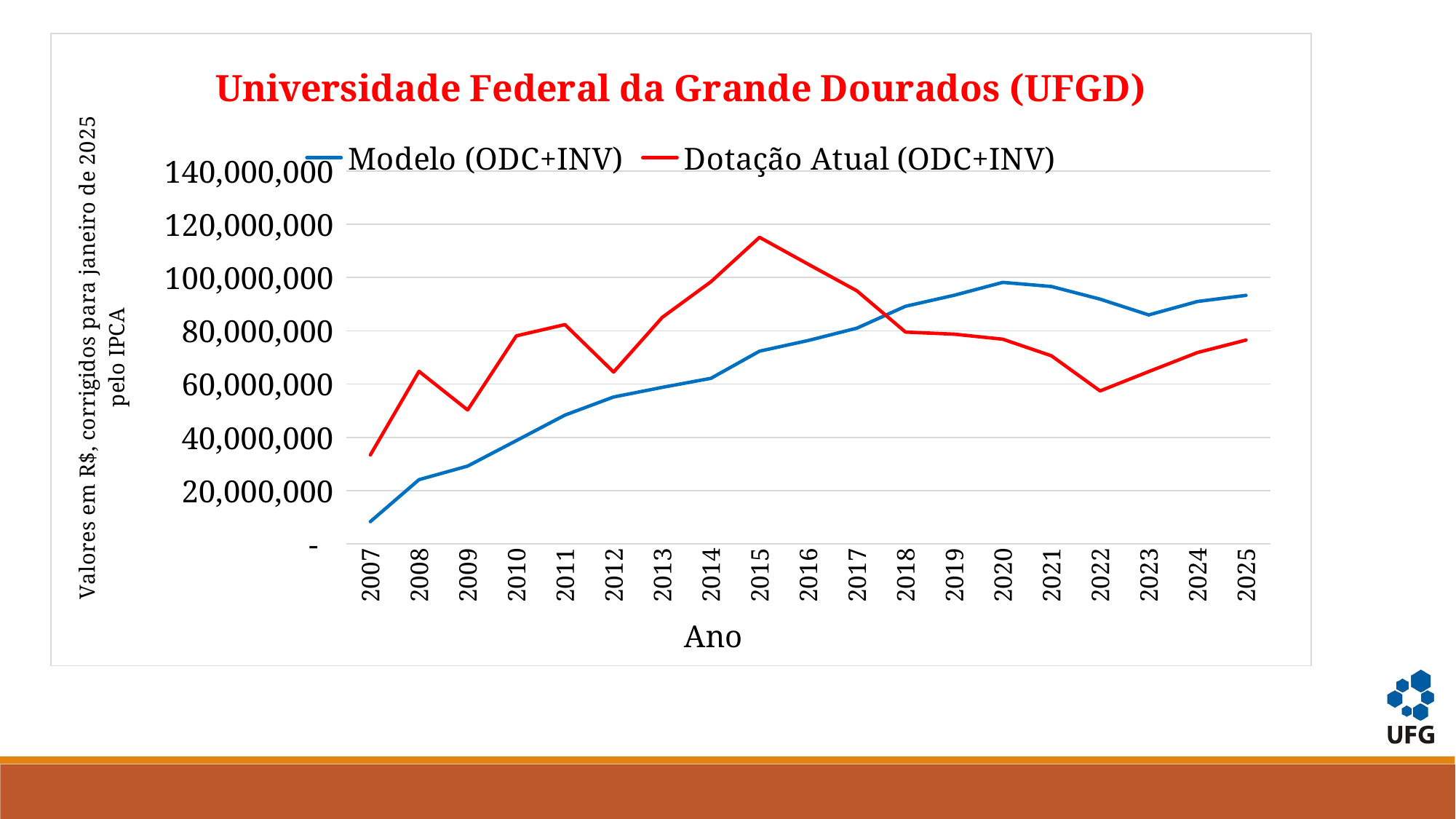
In which year is the Modelo (ODC+INV) series at its lowest value? 2007 How many series does the legend list? 2 Is the value for Modelo (ODC+INV) in 2007 greater or less than 20,000,000? less What is the title of the chart? Universidade Federal da Grande Dourados (UFGD) In which year is the Dotação Atual (ODC+INV) series at its lowest value? 2007 What kind of chart is shown on the slide? Line chart In 2015, which series has the larger value, Modelo (ODC+INV) or Dotação Atual (ODC+INV)? Dotação Atual (ODC+INV) In which year does the Dotação Atual (ODC+INV) series reach its highest value? 2015 Does the Modelo (ODC+INV) series rise or fall from 2007 to 2020? Rise How many years are plotted along the x axis? 19 In 2020, which series has the larger value, Modelo (ODC+INV) or Dotação Atual (ODC+INV)? Modelo (ODC+INV) Is the value for Dotação Atual (ODC+INV) in 2015 greater or less than 100,000,000? greater